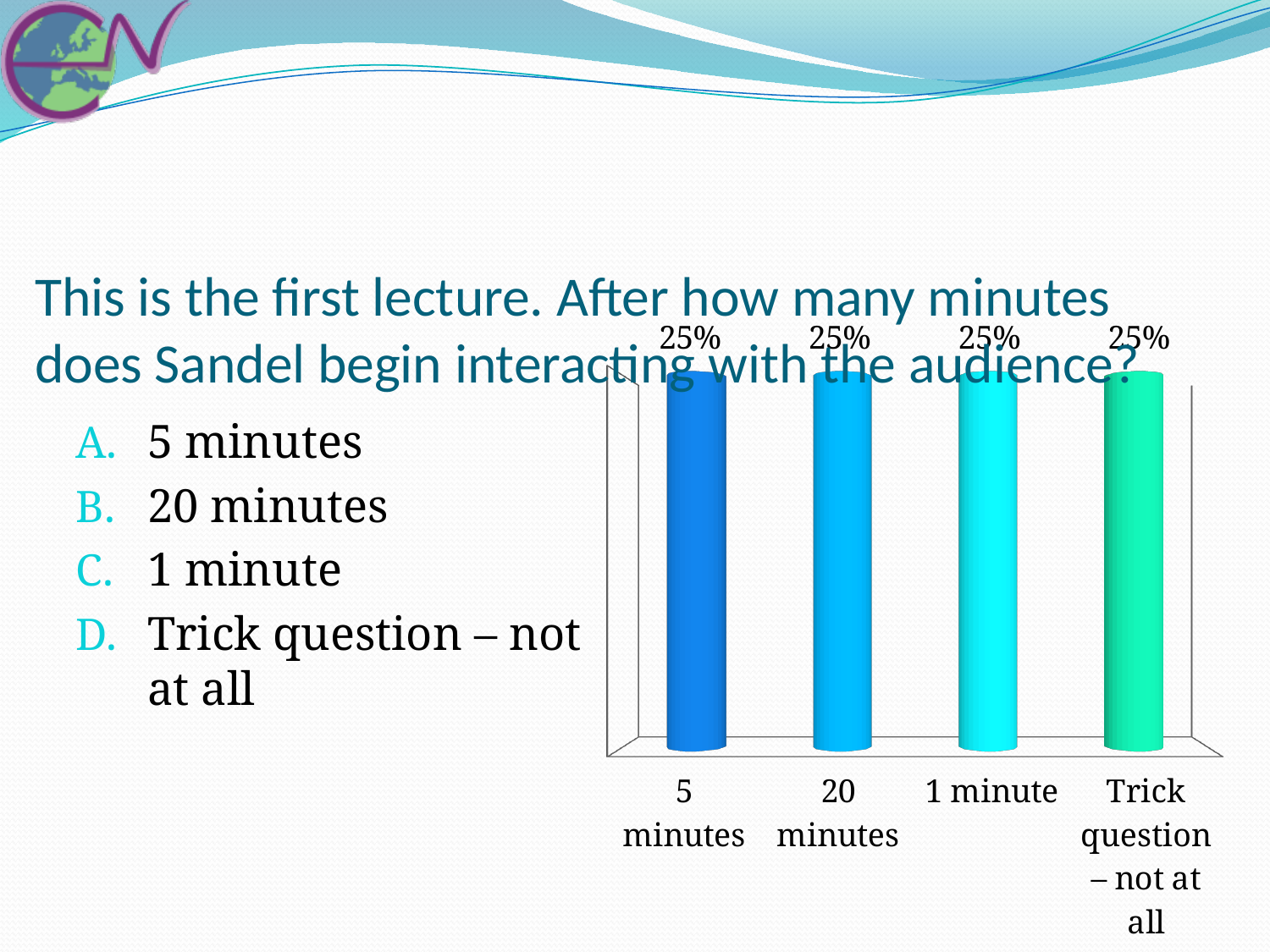
What is the label of the leftmost category on the chart? 5 minutes What is the difference between the values for "5 minutes" and "20 minutes"? 0% What is the value for the "5 minutes" bar? 25% What is the difference between the values for "1 minute" and "Trick question – not at all"? 0% How many categories are shown on the chart? 4 What kind of chart is shown on the slide? bar chart What is the value for the "20 minutes" bar? 25% What is the value for the "1 minute" bar? 25% What is the value for the "Trick question – not at all" bar? 25% What is the label of the rightmost category on the chart? Trick question – not at all Do all four bars have the same value? Yes Do the values rise, fall, or stay the same across the categories from left to right? stay the same